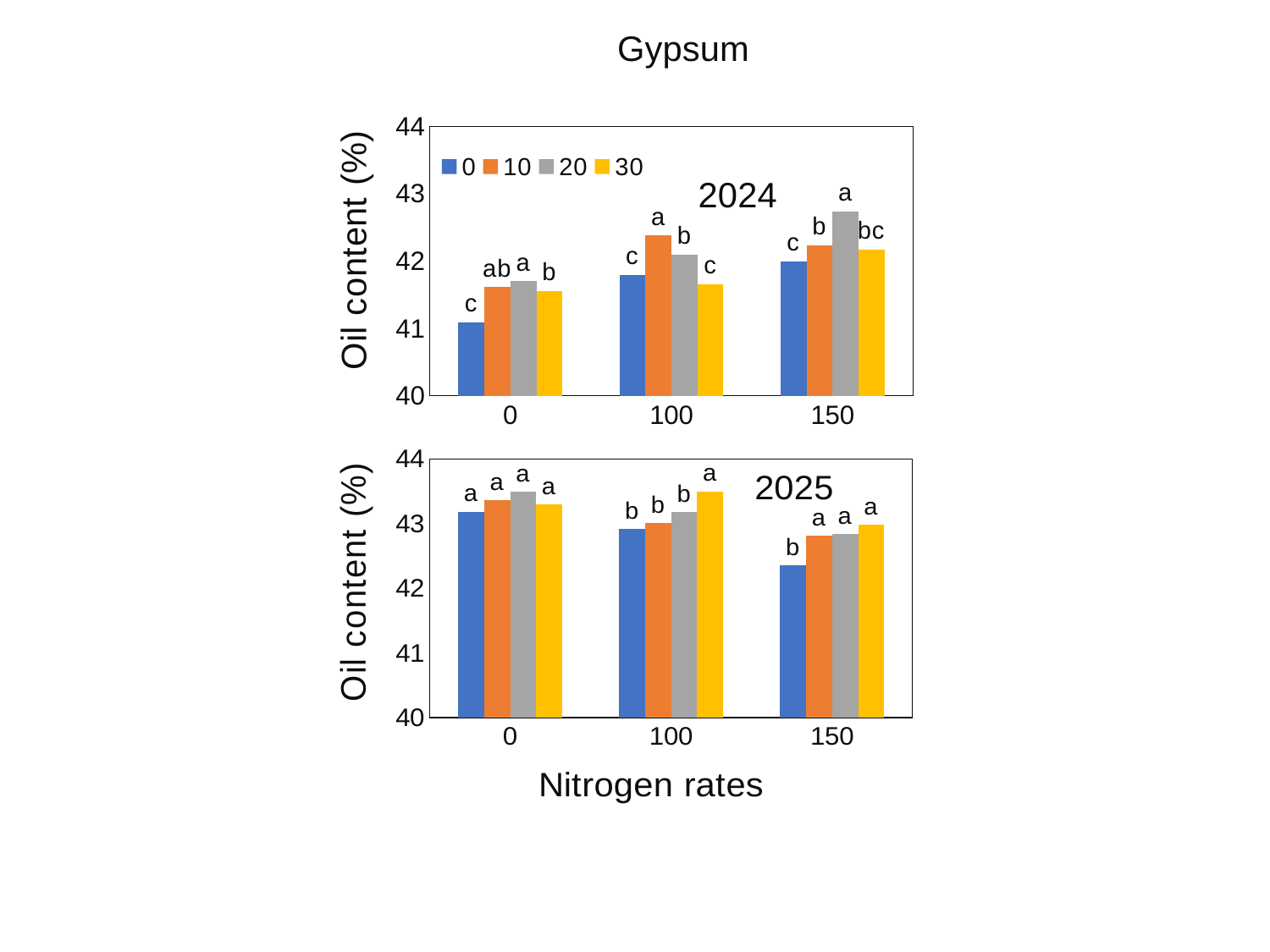
In the 2024 chart, is the value for series 0 at nitrogen rate 0 greater or less than 42? less In the 2024 chart, which gypsum series has the lowest bar at nitrogen rate 0? 0 In the 2025 chart, is the value for series 0 at nitrogen rate 150 greater or less than 43? less In the 2024 chart, do the values for series 0 rise or fall as the nitrogen rate increases from 0 to 150? rise What is the y-axis label of the charts on the slide? Oil content (%) How many series does the legend of the 2024 chart list? 4 What kind of chart is used for the 2024 panel on the slide? bar chart In the 2024 chart, which is larger at nitrogen rate 100: series 10 or series 0? series 10 In the 2025 chart, which gypsum series has the highest bar at nitrogen rate 100? 30 In the 2024 chart, which gypsum series has the highest bar at nitrogen rate 150? 20 How many nitrogen rate categories are shown on the x axis of the 2025 chart? 3 In the 2025 chart, which gypsum series has the lowest bar at nitrogen rate 150? 0